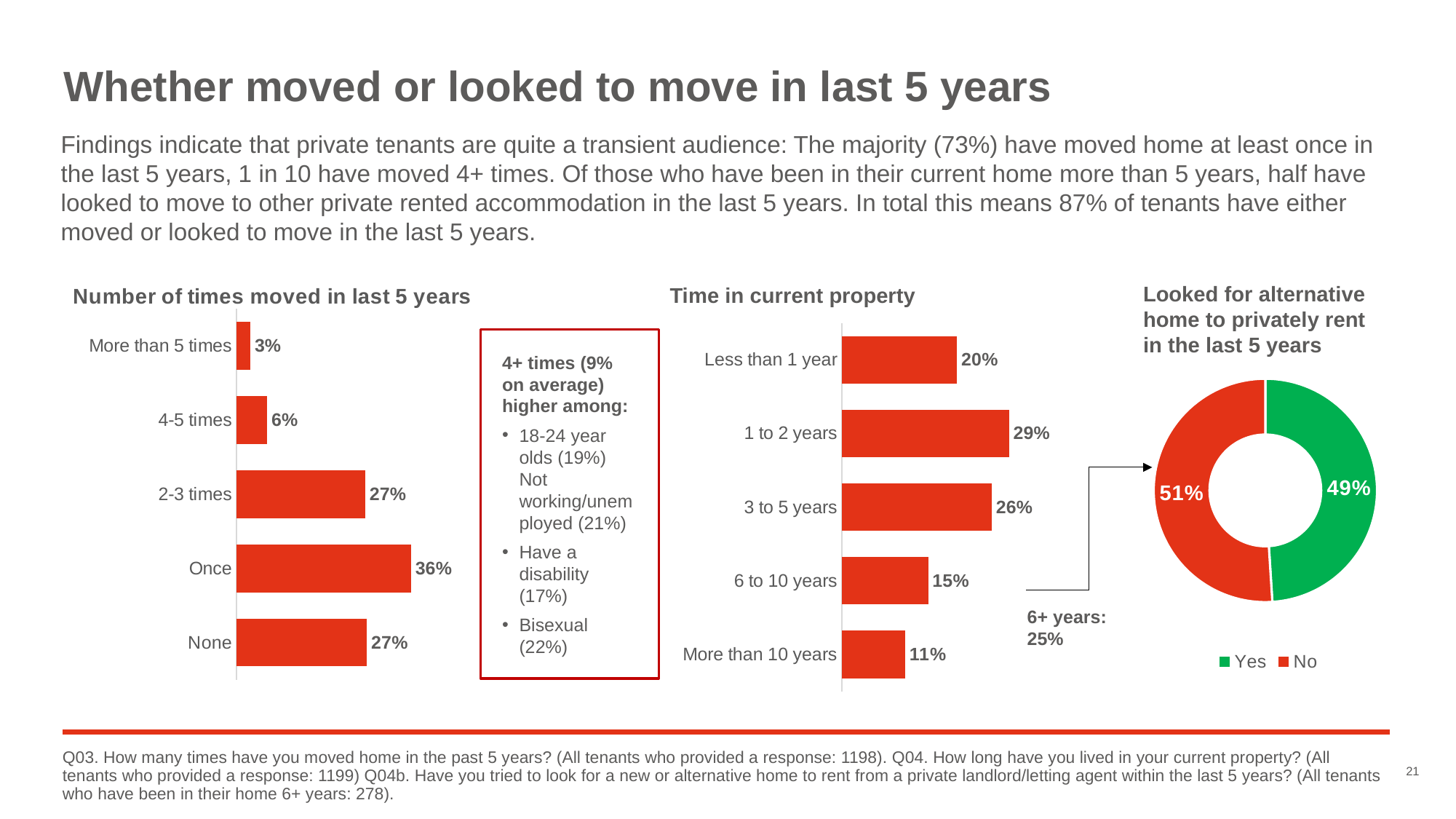
In the 'Looked for alternative home to privately rent in the last 5 years' chart, which colour represents 'No'? Red What kind of chart is 'Time in current property'? Bar chart In the 'Number of times moved in last 5 years' chart, what is the difference between 'Once' and '2-3 times'? 9% In the 'Time in current property' chart, which category has the highest value? 1 to 2 years In the 'Number of times moved in last 5 years' chart, which category has the lowest value? More than 5 times In the 'Time in current property' chart, which is larger: 'Less than 1 year' or '6 to 10 years'? Less than 1 year In the 'Number of times moved in last 5 years' chart, how many categories are shown? 5 How many entries does the legend of the 'Looked for alternative home to privately rent in the last 5 years' chart list? 2 In the 'Time in current property' chart, what is the value for '3 to 5 years'? 26% In the 'Time in current property' chart, what is the difference between '6 to 10 years' and 'More than 10 years'? 4% In the 'Number of times moved in last 5 years' chart, what is the value for 'Once'? 36% In the 'Looked for alternative home to privately rent in the last 5 years' chart, what share of respondents answered 'Yes'? 49%